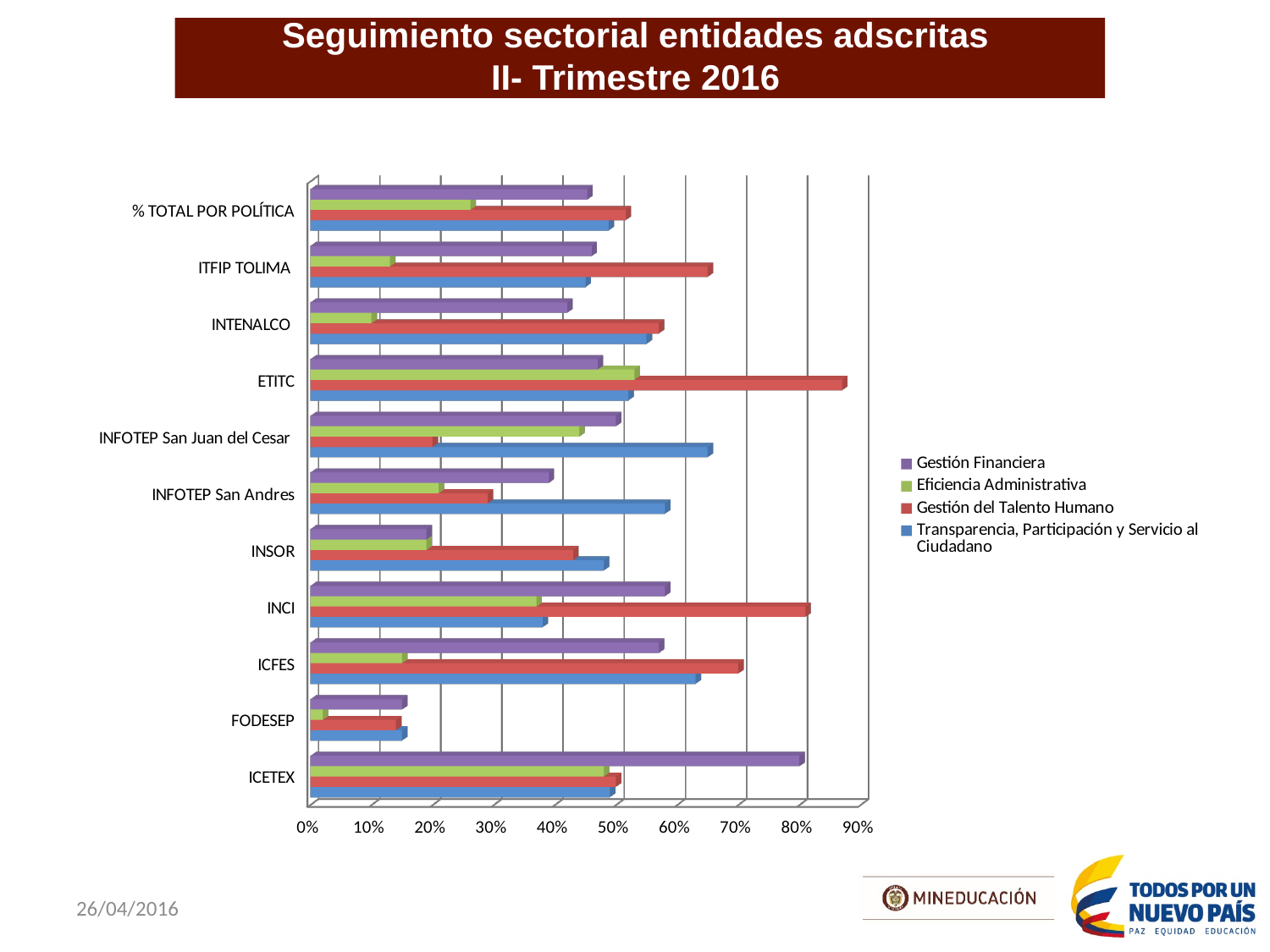
Which entity has the highest value for Gestión del Talento Humano? ETITC Which has the larger Gestión del Talento Humano value, INCI or ICFES? INCI What colour represents Gestión del Talento Humano in the chart's legend? Red Is the Gestión del Talento Humano value for ETITC greater or less than 80%? greater Is the Eficiencia Administrativa value for FODESEP greater or less than 10%? less Which entity has the lowest value for Eficiencia Administrativa? FODESEP For INFOTEP San Juan del Cesar, which is larger: Transparencia, Participación y Servicio al Ciudadano or Gestión del Talento Humano? Transparencia, Participación y Servicio al Ciudadano How many categories (entities) are listed on the vertical axis of the chart? 11 Is the Gestión Financiera value for ICETEX greater or less than 70%? greater What kind of chart is shown on the slide? Bar chart Which entity has the highest value for Gestión Financiera? ICETEX How many series does the chart's legend list? 4